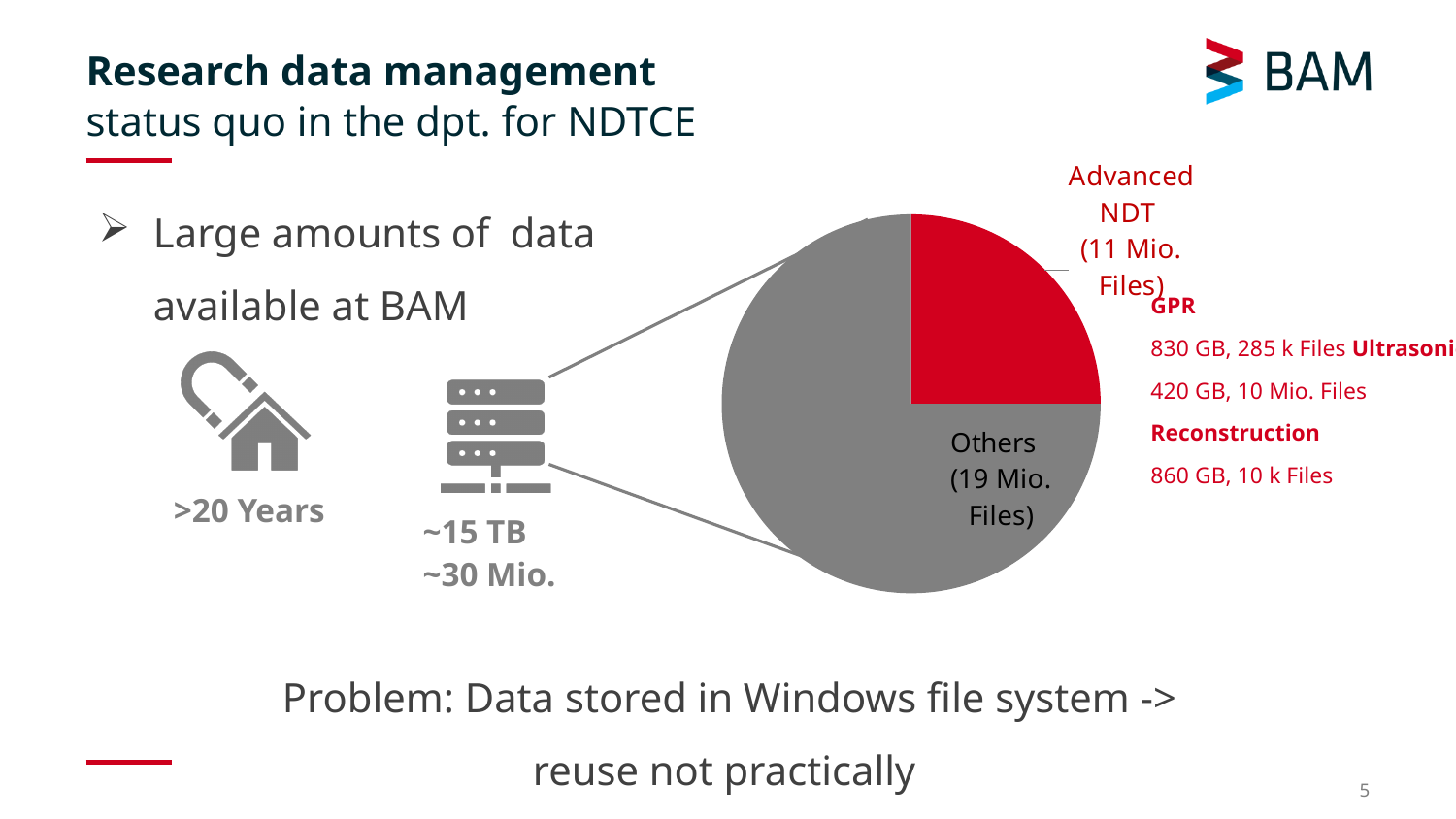
What colour is the Advanced NDT slice of the pie chart? Red What colour is the Others slice of the pie chart? Grey How many files does the Advanced NDT slice of the pie chart represent? 11 Mio. Files What is the total number of files represented by both slices of the pie chart? 30 Mio. Files Which slice of the pie chart is the smallest? Advanced NDT Which slice of the pie chart is the largest? Others How many files does the Others slice of the pie chart represent? 19 Mio. Files How many more files does the Others slice represent than the Advanced NDT slice? 8 Mio. Files What kind of chart is shown on the slide? Pie chart Which slice represents more files, Advanced NDT or Others? Others How many slices does the pie chart have? 2